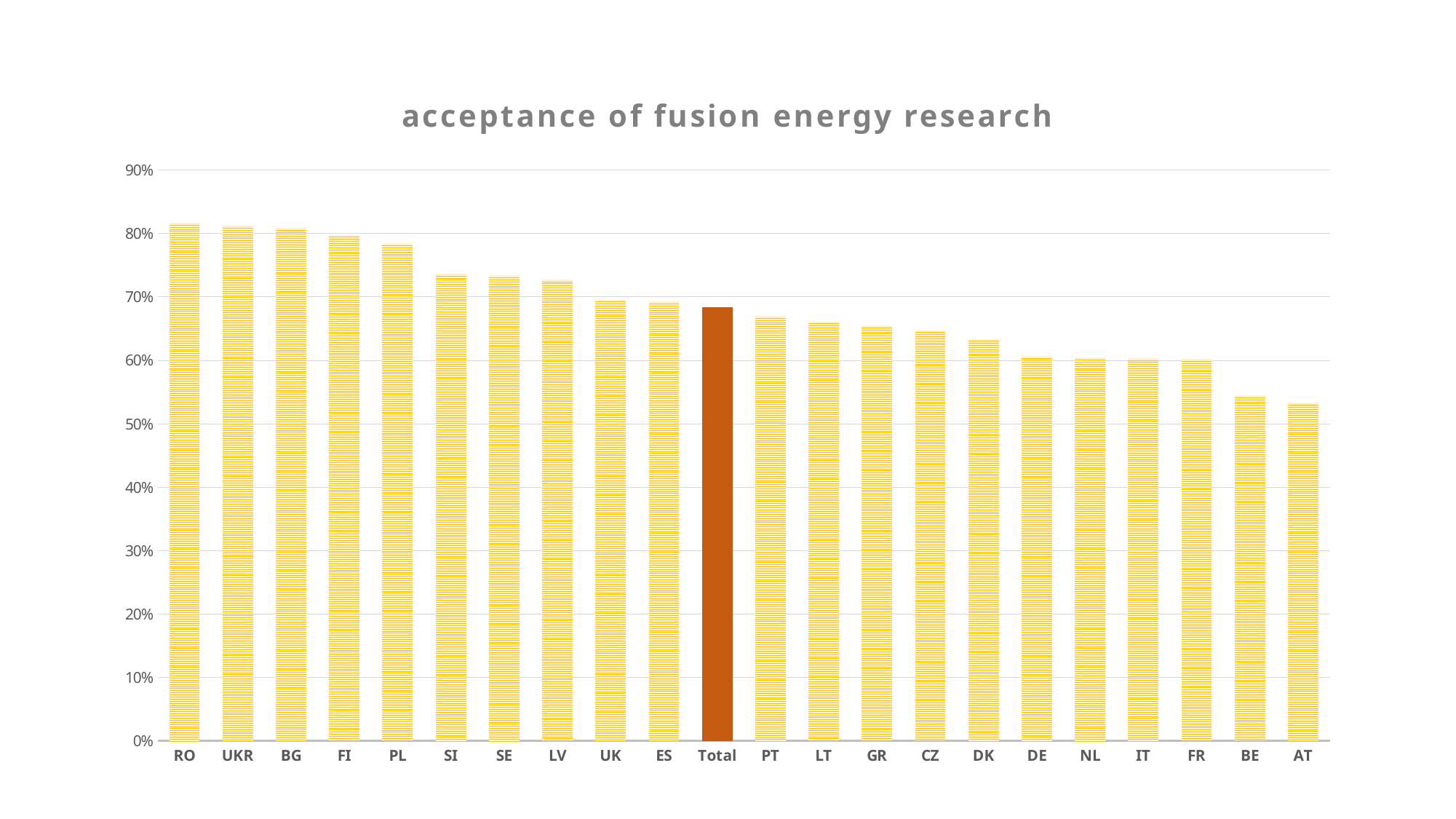
Is the value for RO greater or less than 80%? greater Is the value for Total greater or less than 70%? less What kind of chart is shown on the slide? bar chart Which has a higher value, PL or SI? PL Is the value for DK greater or less than 60%? greater What is the title of the chart? acceptance of fusion energy research Which category has the lowest value in the chart? AT How many bars (categories) are plotted in the chart? 22 Which bar is drawn in a different colour from the others? Total Do the values generally rise or fall moving from left to right along the x axis? fall